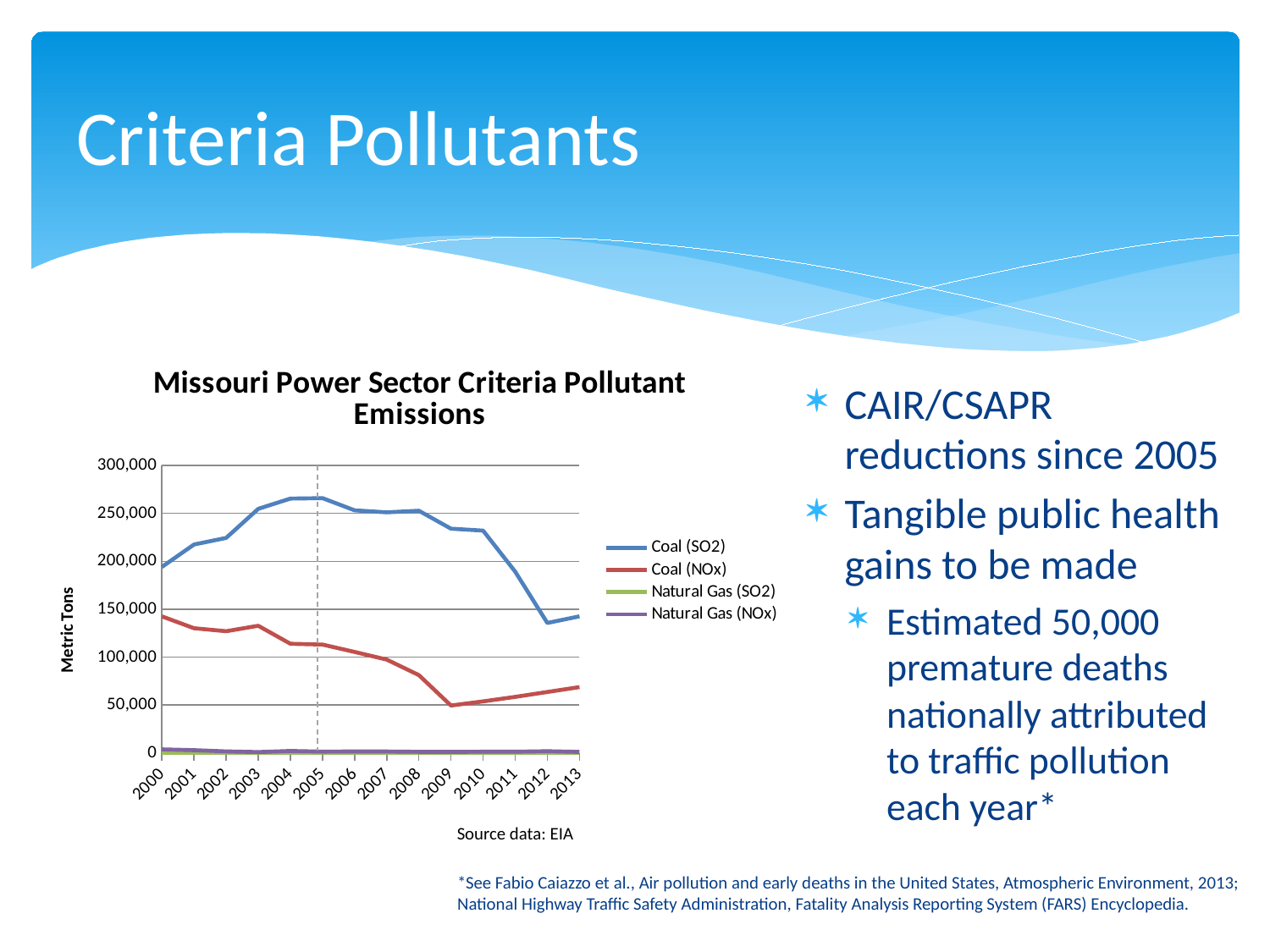
In which year is the Coal (NOx) value lowest? 2009 What kind of chart is shown on the slide? line chart What is the label on the y axis of the chart? Metric Tons How many years are shown along the x axis of the chart? 14 Is the value for Coal (NOx) in 2009 greater or less than 100,000? less In 2005, which is larger: Coal (SO2) or Coal (NOx)? Coal (SO2) Is the value for Coal (SO2) in 2012 greater or less than 150,000? less Is the value for Coal (SO2) in 2005 greater or less than 250,000? greater Does the Coal (NOx) line rise or fall from 2000 to 2009? fall In which year is the Coal (SO2) value lowest? 2012 How many series does the legend of the Missouri Power Sector Criteria Pollutant Emissions chart list? 4